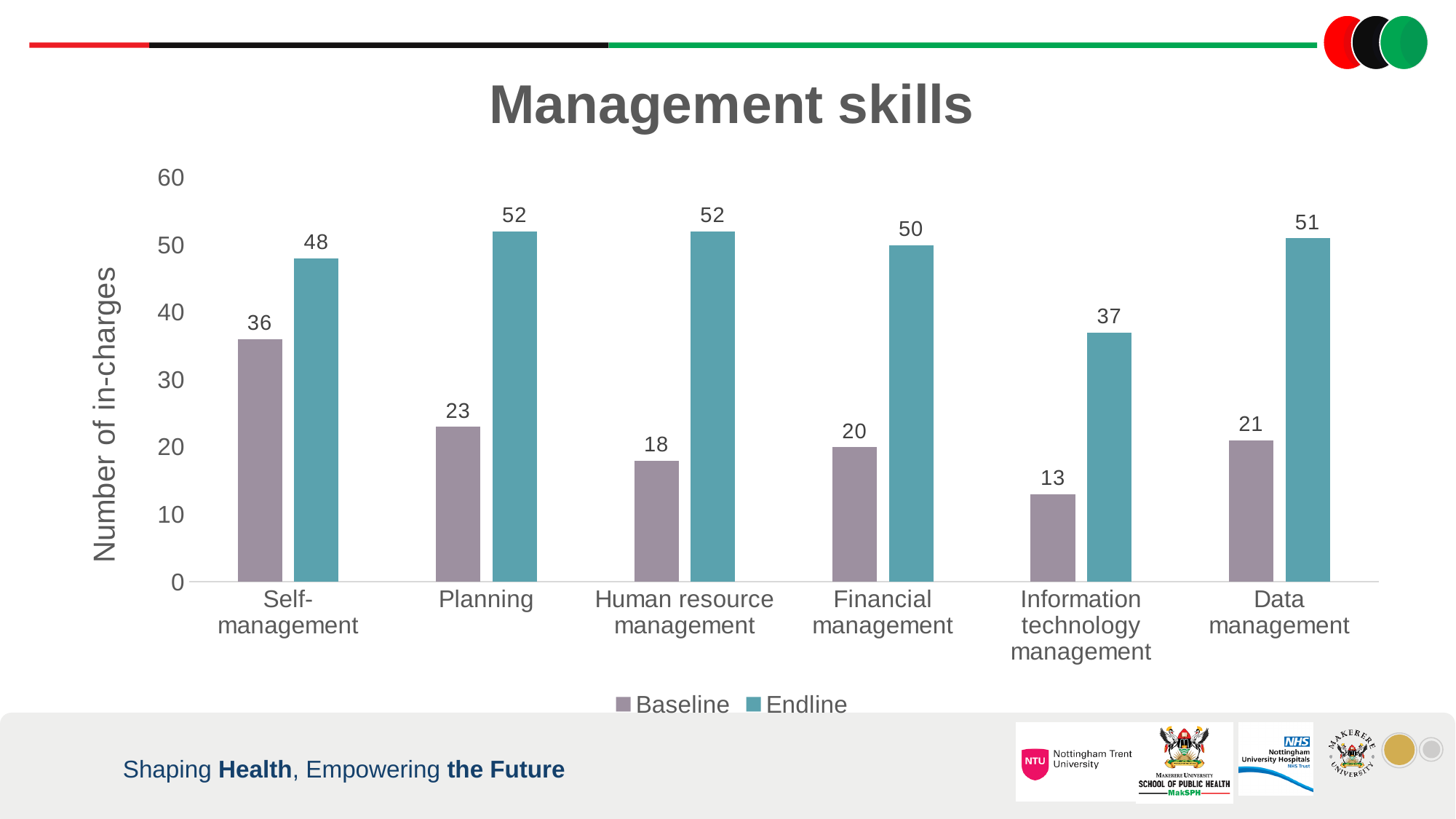
How many categories are shown on the x axis? 6 What kind of chart is shown on the slide? Bar chart What is the Endline value for Information technology management? 37 How many series does the legend list? 2 What is the Endline value for Data management? 51 Which category has the lowest Baseline value? Information technology management What is the Baseline value for Self-management? 36 What is the label of the vertical axis? Number of in-charges What is the difference between the Endline and Baseline values for Human resource management? 34 What is the difference between the Endline and Baseline values for Planning? 29 Which is larger, the Baseline value for Financial management or the Baseline value for Data management? Data management Which category has the highest Baseline value? Self-management